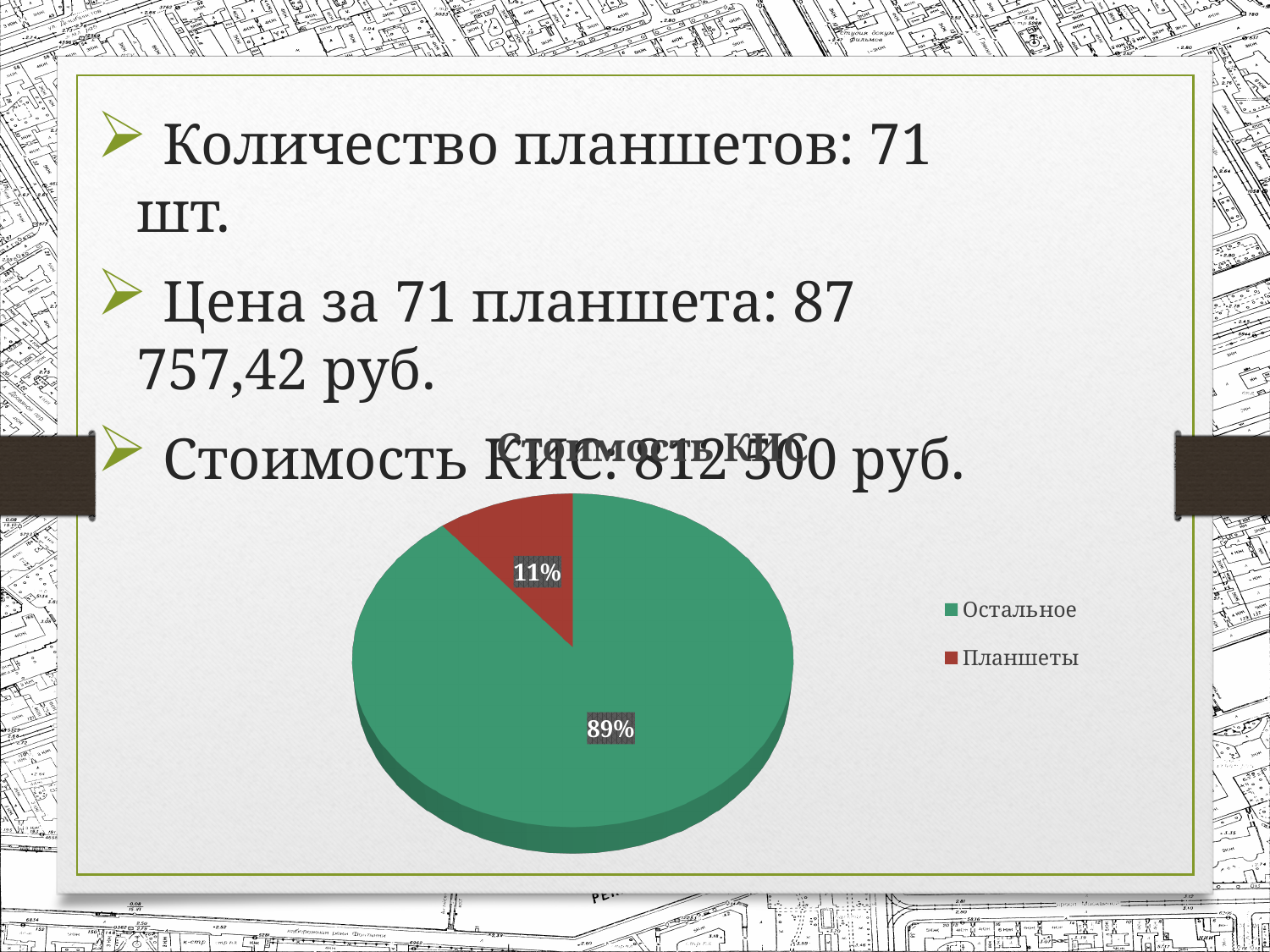
Which slice of the pie is the smallest? Планшеты Which is larger, the share for Остальное or the share for Планшеты? Остальное What share of the pie does Остальное take? 89% What colour is the Планшеты slice? red What colour is the Остальное slice? green Which slice of the pie is the largest? Остальное What share of the pie does Планшеты take? 11% How many slices does the pie chart have? 2 What is the difference in percentage points between the Остальное and Планшеты slices? 78 How many entries does the legend list? 2 What kind of chart is shown on the slide? pie chart